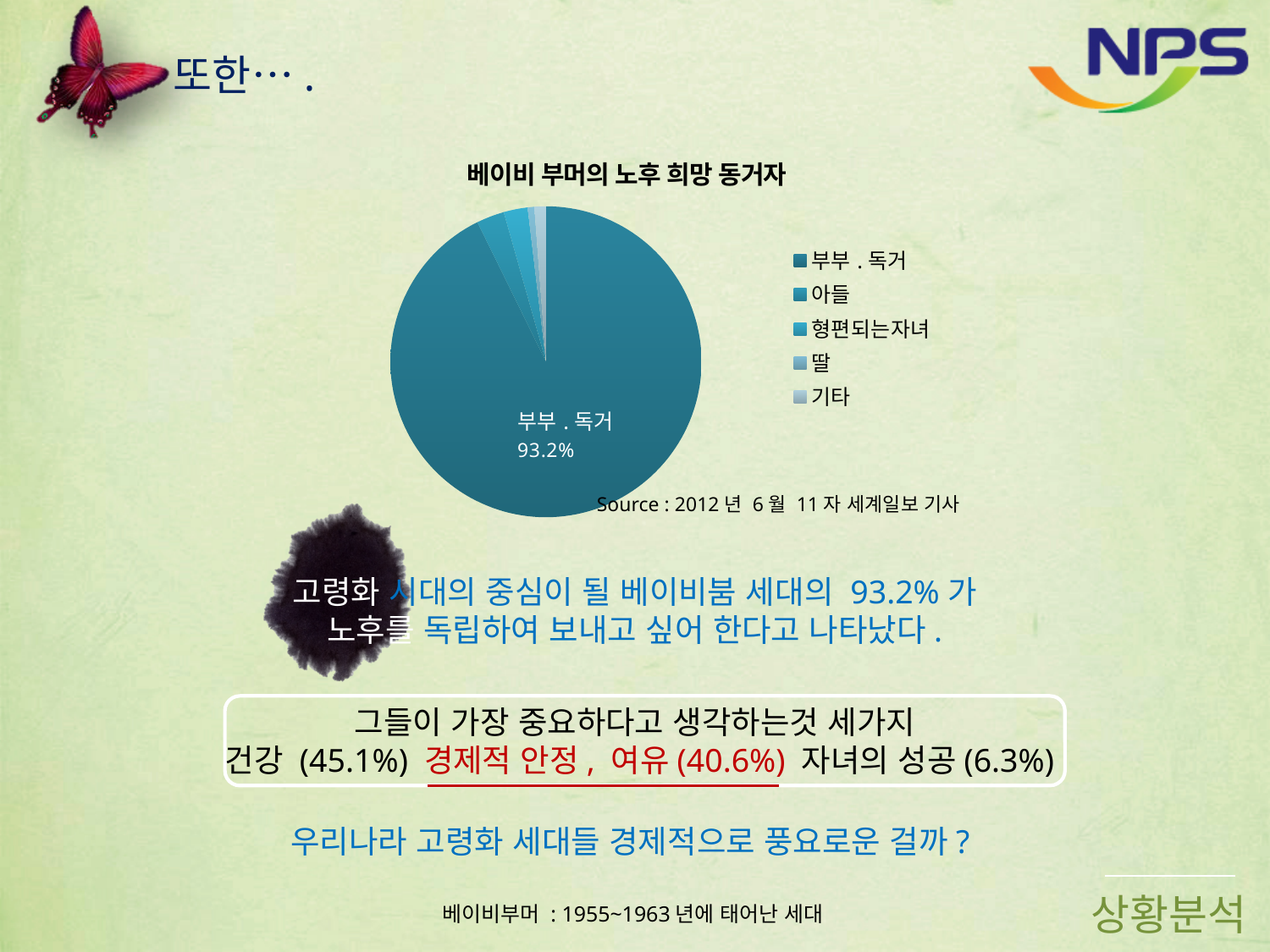
What value is printed on the 부부 . 독거 slice? 93.2% Which category has the largest slice in the pie chart? 부부 . 독거 Which category is listed first in the legend of the pie chart? 부부 . 독거 What is the title of the pie chart? 베이비 부머의 노후 희망 동거자 Which slice is larger, 부부 . 독거 or 기타? 부부 . 독거 What kind of chart is shown on the slide? pie chart How many categories does the legend of the pie chart list? 5 Which slice is larger, 부부 . 독거 or 아들? 부부 . 독거 What share of the pie does 부부 . 독거 account for? 93.2%